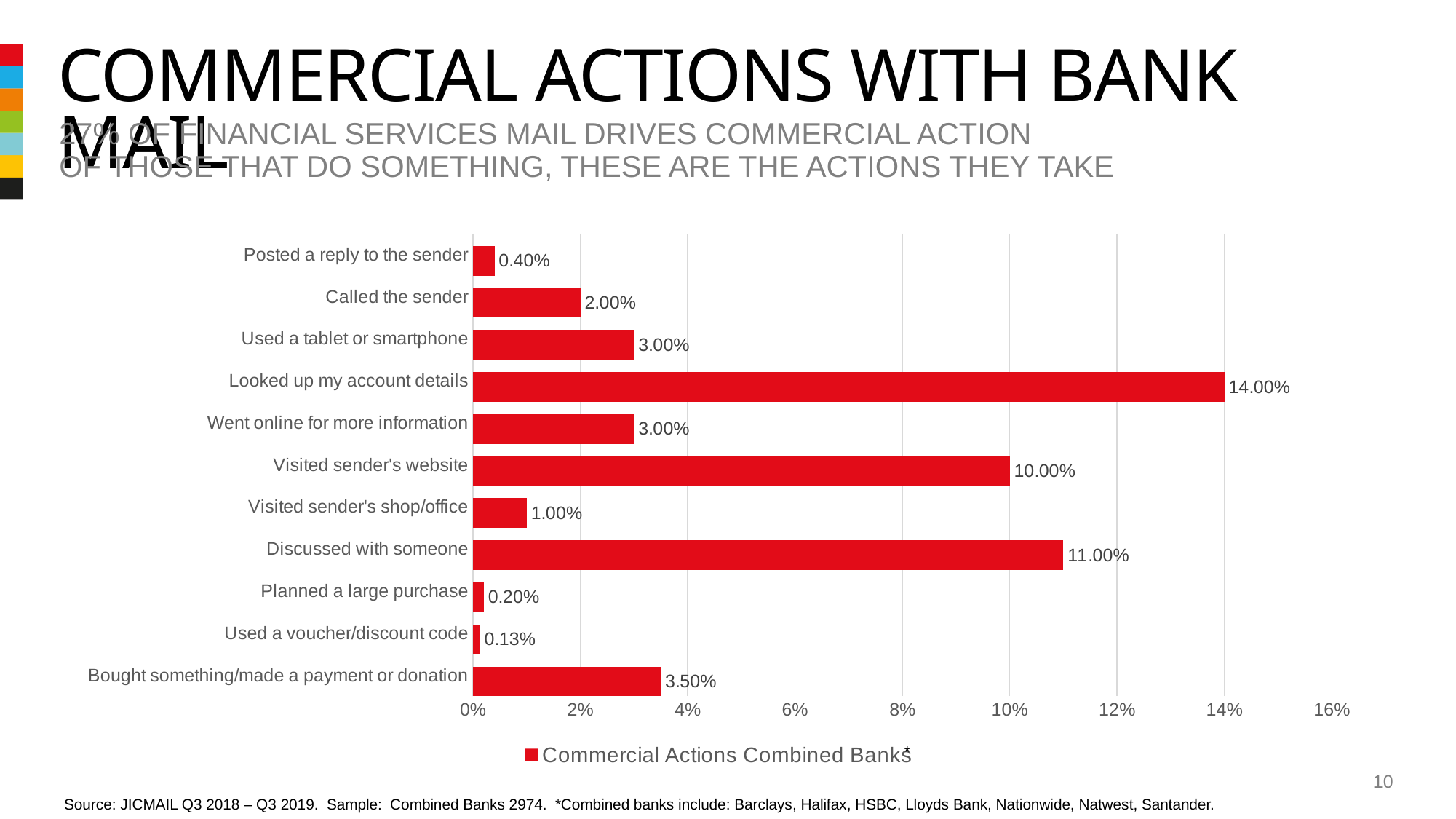
What is the difference between "Discussed with someone" and "Visited sender's website"? 1.00% Which category has the lowest value? Used a voucher/discount code What is the value for "Used a voucher/discount code"? 0.13% What is the value for "Looked up my account details"? 14.00% What is the value for "Bought something/made a payment or donation"? 3.50% Which is larger, "Called the sender" or "Visited sender's shop/office"? Called the sender Is the value for "Discussed with someone" greater or less than 10%? greater Which category has the highest value? Looked up my account details How many categories are shown in the chart? 11 What is the legend entry for the series in the chart? Commercial Actions Combined Banks* What kind of chart is shown on the slide? Bar chart How many series does the legend list? 1